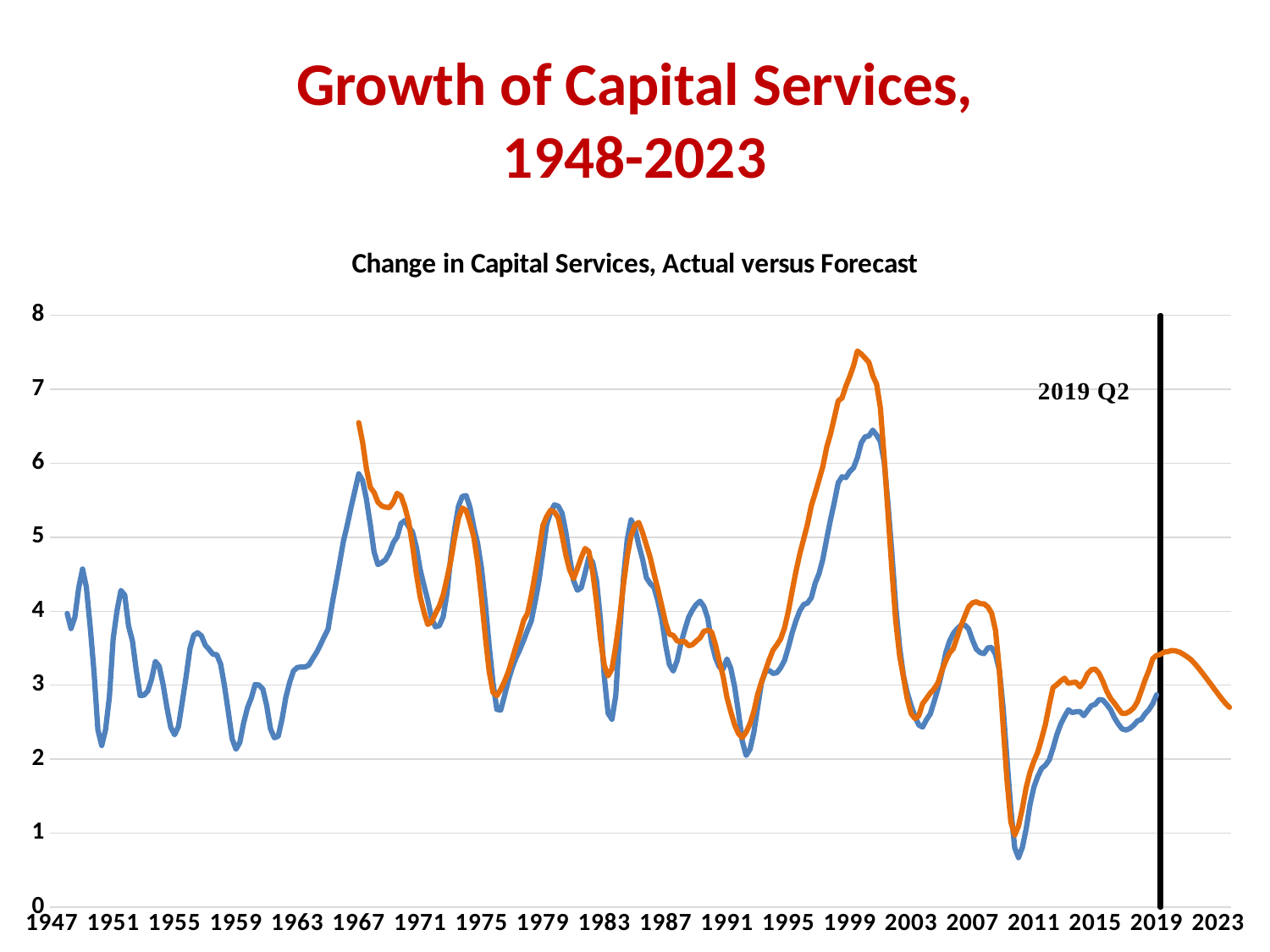
Does the blue line rise or fall between 1995 and 1999? rise Is the value of the blue line in 1959 greater or less than 3? less What is the title of the chart? Change in Capital Services, Actual versus Forecast Is the value of the orange line in 2023 greater or less than 3? less Is the peak value of the orange line around 1999-2000 greater or less than 7? greater What label is written next to the vertical black line on the chart? 2019 Q2 What kind of chart is shown on the slide? line chart Does the orange line rise or fall between 2021 and 2023? fall Around 1999, which line is higher, the orange line or the blue line? orange line